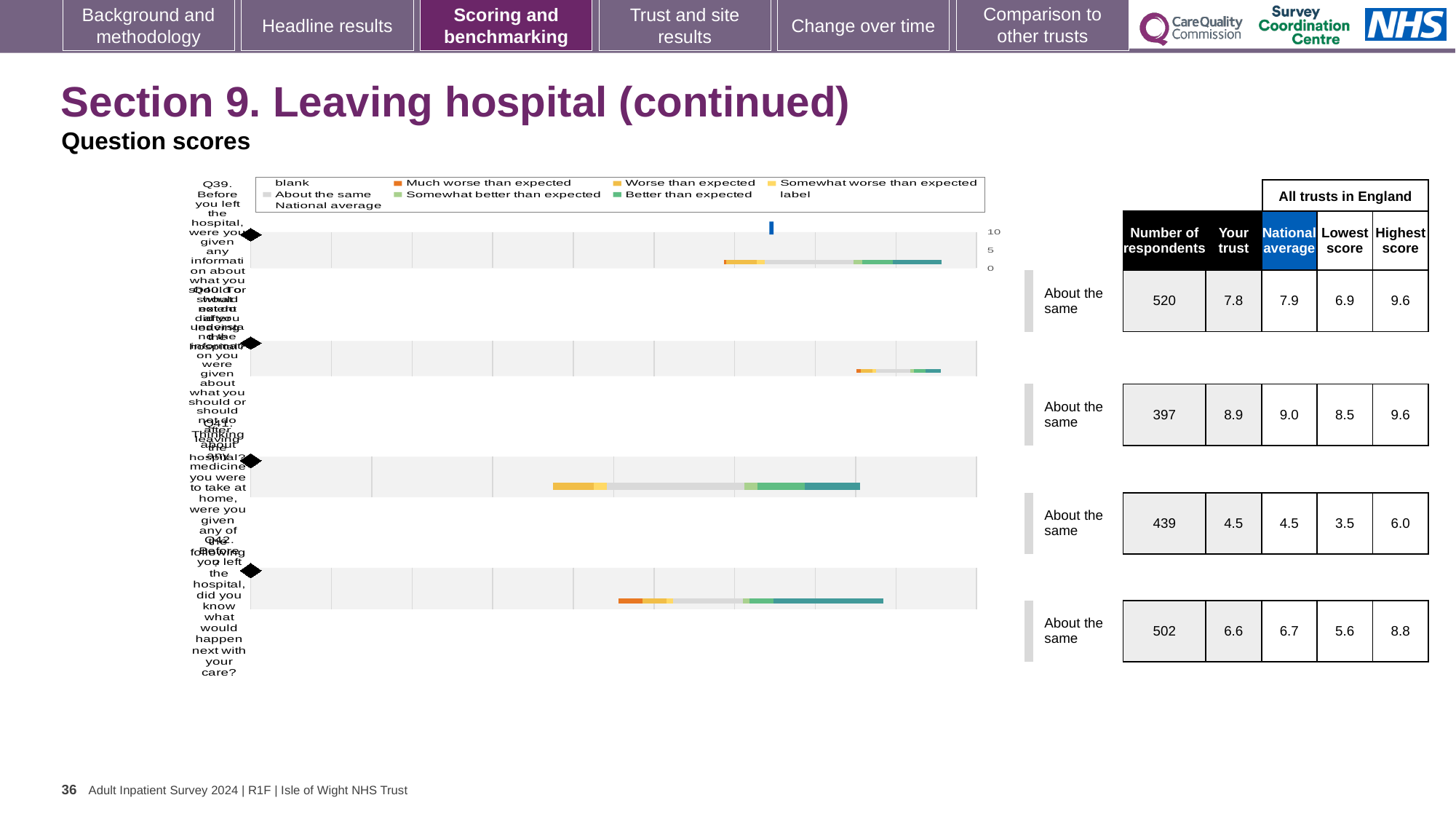
In the table beside the chart, for the second row (Q40), which is larger: the 'Your trust' score or the national average? National average (9.0) In the table beside the chart, what is the difference between the highest and lowest scores in England for the first row (Q39)? 2.7 In the table beside the chart, what is the lowest score in England for the fourth row (Q42)? 5.6 In the table beside the chart, which row has the highest 'Your trust' score? the second row (Q40), 8.9 What kind of chart is shown on the slide? bar chart In the table beside the chart, what is the highest score in England for the third row (Q41)? 6.0 In the table beside the chart, how many respondents are listed for the first row (Q39)? 520 In the table beside the chart, what is the 'Your trust' score for the first row (Q39)? 7.8 How many question rows (Q39 to Q42) are plotted in the chart? 4 What is the highest tick value shown on the chart's score axis? 10 In the table beside the chart, which row has the lowest 'Your trust' score? the third row (Q41), 4.5 Which colour does the legend use for 'Much worse than expected'? orange